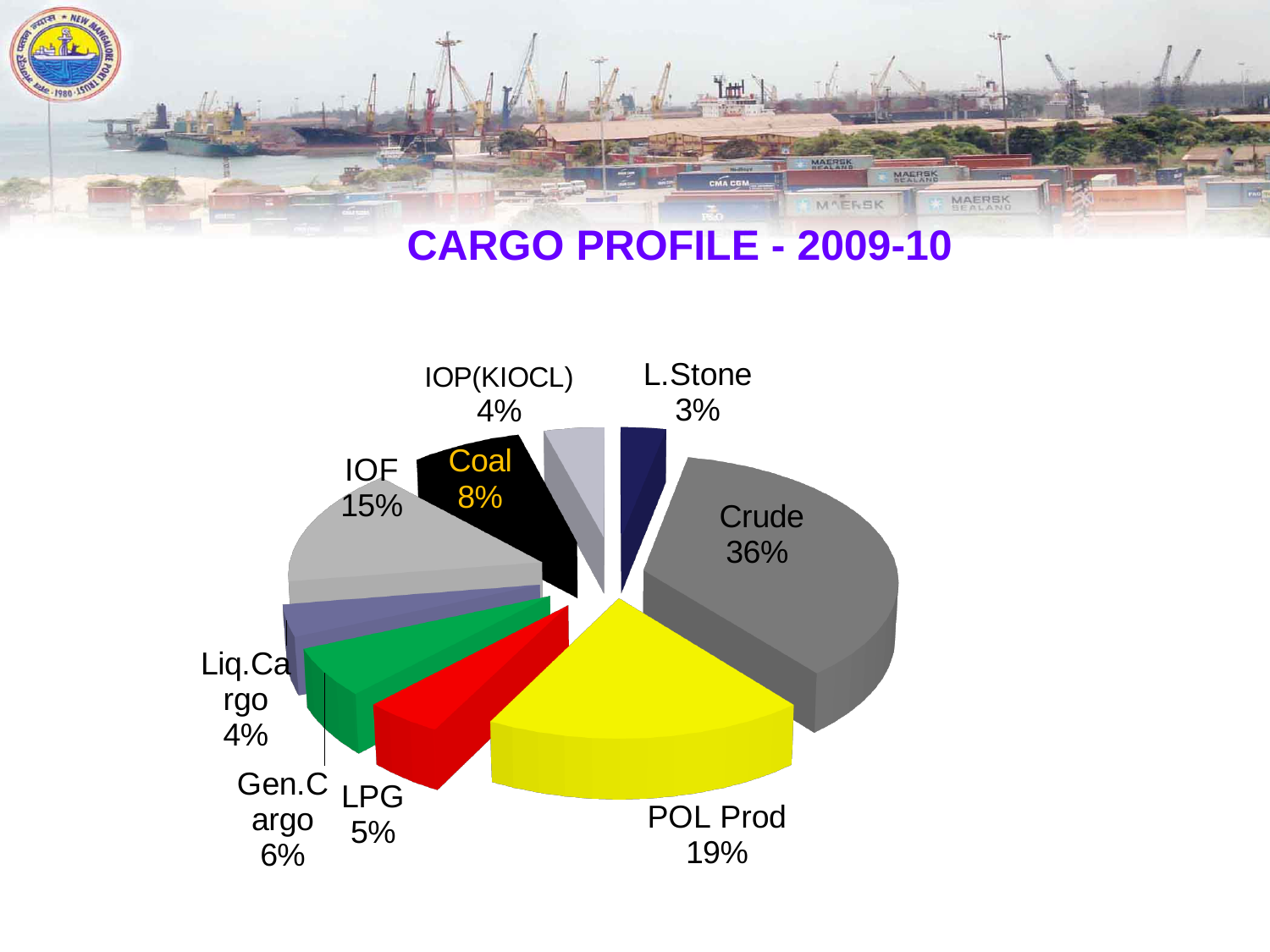
What percentage is shown for POL Prod? 19% What share of the pie does Crude account for? 36% What percentage is shown for Coal? 8% Which cargo category has the smallest share of the pie? L.Stone How many slices does the pie chart have? 9 What percentage is shown for L.Stone? 3% Which cargo category has the largest share of the pie? Crude What kind of chart is shown on the slide? pie chart What is the difference in percentage points between Crude and POL Prod? 17 What percentage is shown for IOF? 15% What is the title of the chart? CARGO PROFILE - 2009-10 Which is larger, the share for Gen.Cargo or the share for LPG? Gen.Cargo